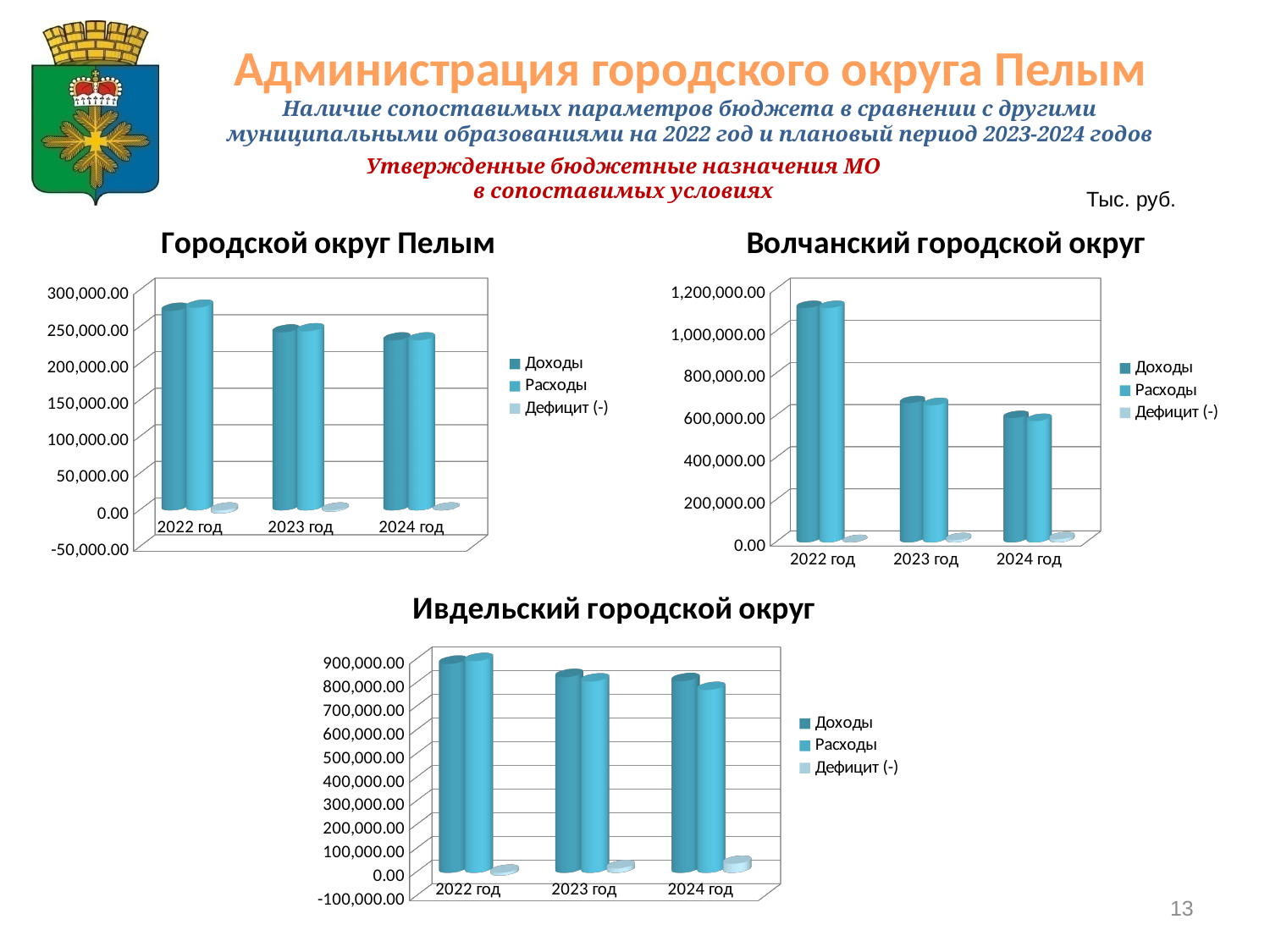
In the "Волчанский городской округ" chart, is the value of Доходы for 2022 год greater or less than 1,000,000.00? greater In the "Городской округ Пелым" chart, is the value of Доходы for 2022 год greater or less than 250,000.00? greater In the "Волчанский городской округ" chart, is the value of Расходы for 2023 год greater or less than 800,000.00? less In the "Волчанский городской округ" chart, do the Доходы values rise or fall from 2022 год to 2024 год? fall How many year categories are shown on the x axis of the "Ивдельский городской округ" chart? 3 What kind of chart is the "Городской округ Пелым" chart? bar chart In the "Волчанский городской округ" chart, which year has the highest value of Доходы? 2022 год In the "Волчанский городской округ" chart, which year has the lowest value of Доходы? 2024 год What is the unit of measurement stated on the slide for the charts? Тыс. руб. How many series does the legend of the "Волчанский городской округ" chart list? 3